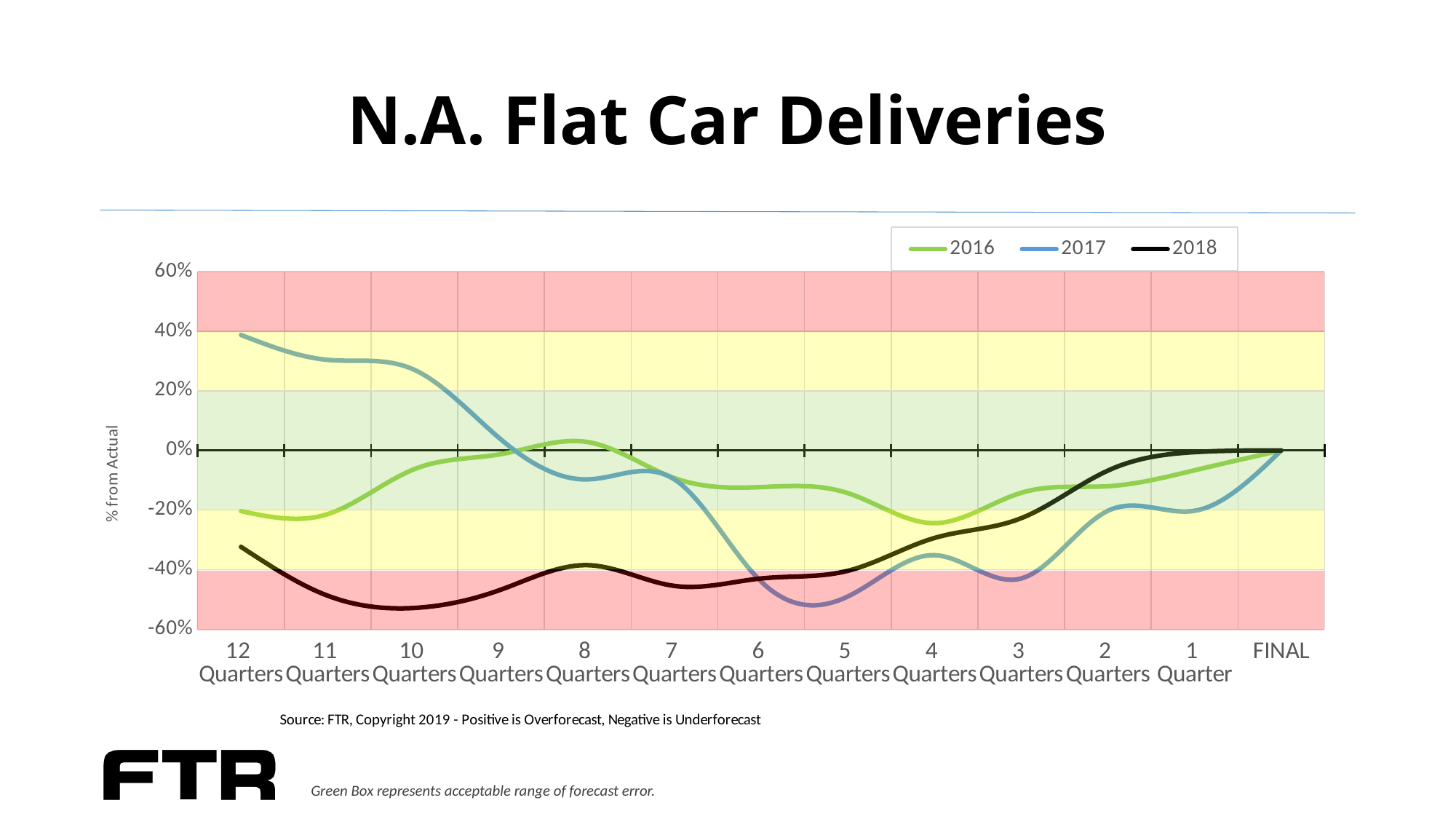
Which series has the highest value at 12 Quarters? 2017 Is the value for 2018 at 10 Quarters greater or less than -40%? less Is the value for 2017 at 5 Quarters greater or less than -40%? less How many categories are shown along the x axis? 13 What kind of chart is shown on the slide? line chart How many series does the legend list? 3 Which series has the lowest value at 12 Quarters? 2018 Is the value for 2018 at 12 Quarters greater or less than -20%? less Does the 2018 line rise or fall from 10 Quarters to FINAL? rise At 6 Quarters, which series has the larger value, 2016 or 2017? 2016